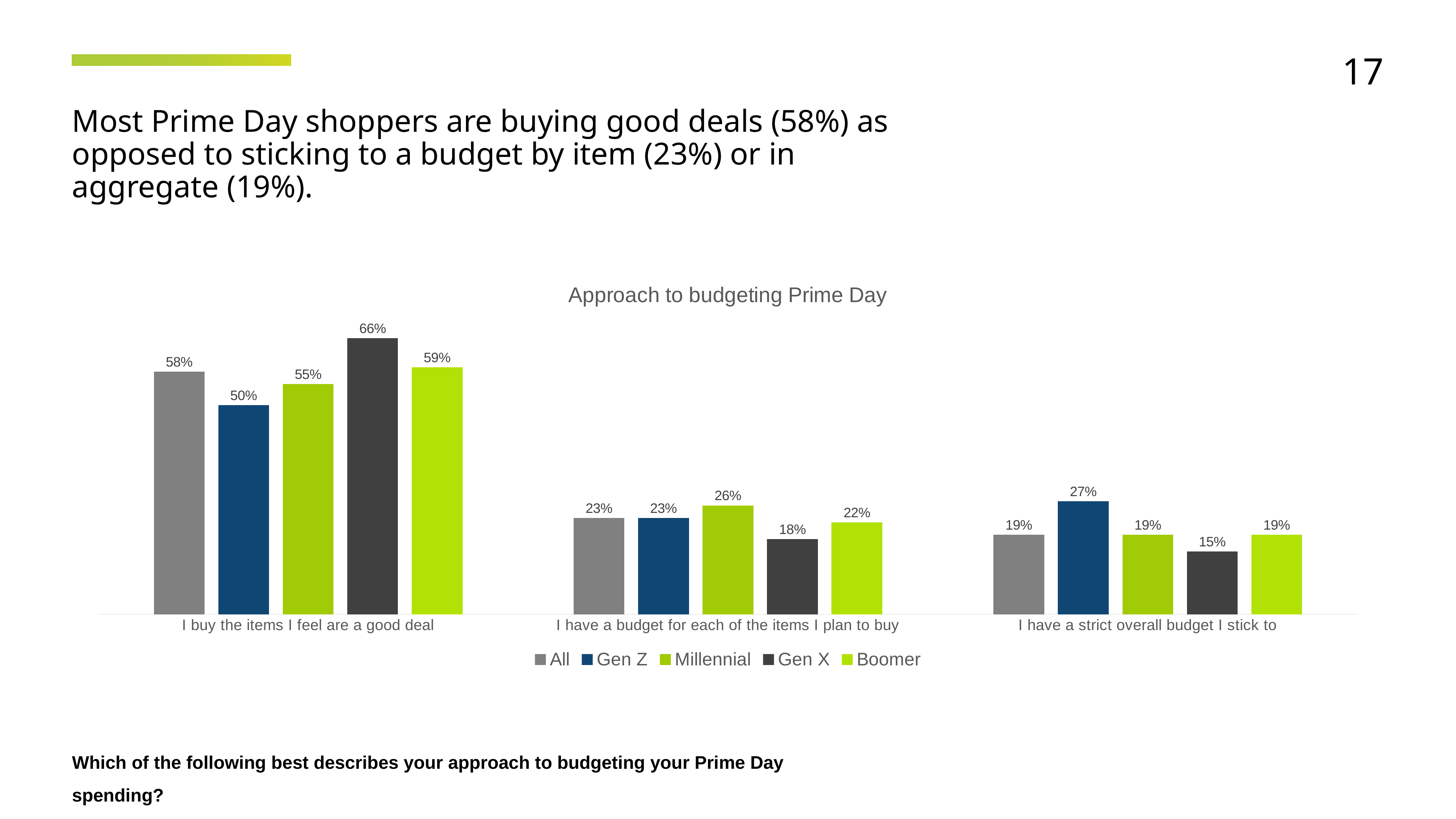
How many categories are shown on the x axis? 3 What is the difference between the Gen Z and Gen X values in the category 'I have a strict overall budget I stick to'? 12% What is the value for Gen X in the category 'I buy the items I feel are a good deal'? 66% How many series does the legend list? 5 What kind of chart is shown on the slide? Bar chart What is the value for Boomer in the category 'I have a budget for each of the items I plan to buy'? 22% Which series has the lowest value in the category 'I have a strict overall budget I stick to'? Gen X What is the title of the chart? Approach to budgeting Prime Day What is the value for Gen Z in the category 'I have a strict overall budget I stick to'? 27% Which series has the highest value in the category 'I buy the items I feel are a good deal'? Gen X What is the difference between the Gen X and Gen Z values in the category 'I buy the items I feel are a good deal'? 16% Which is larger in the category 'I have a budget for each of the items I plan to buy': Millennial or Gen X? Millennial